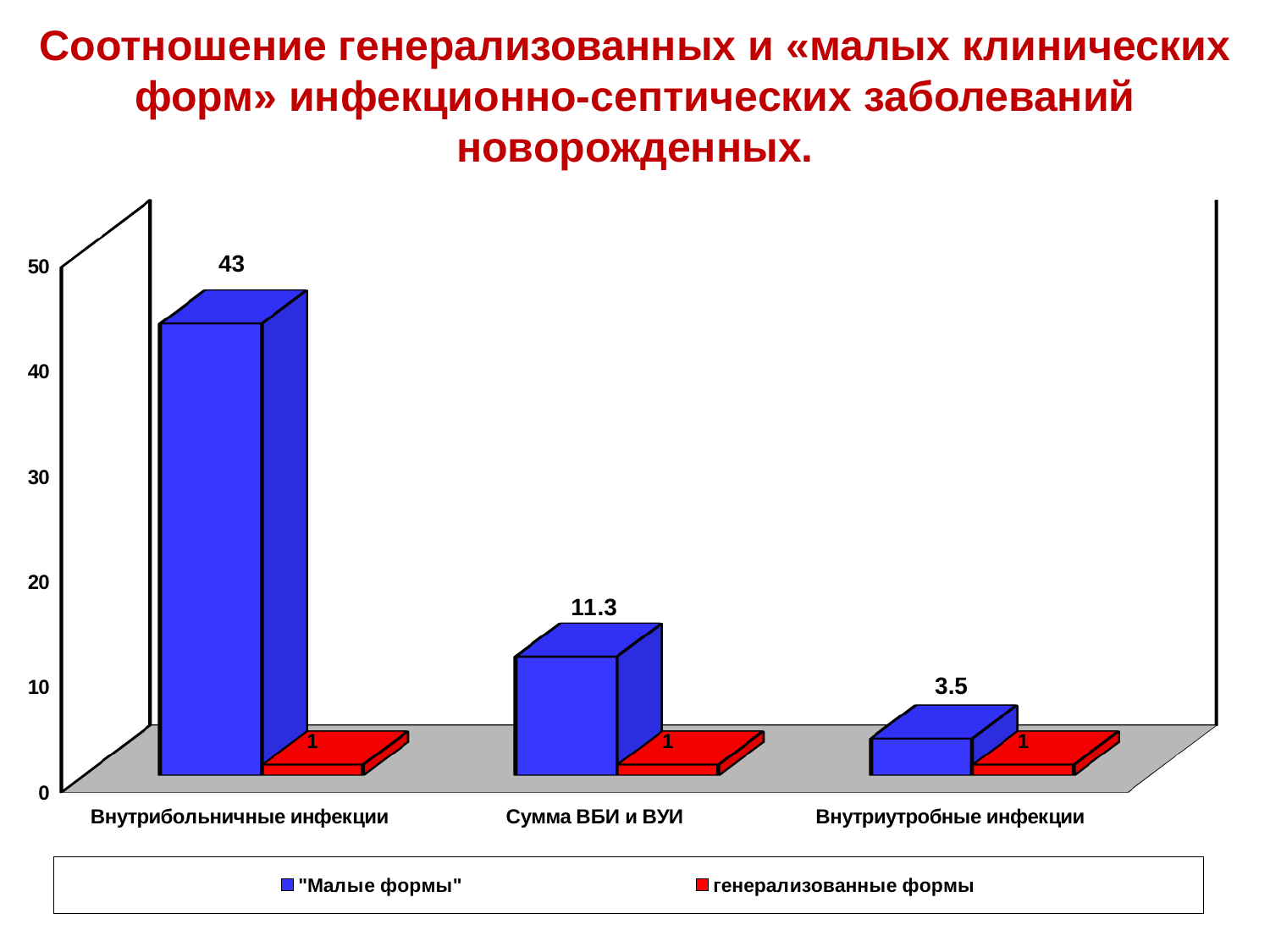
What is the value of генерализованные формы for Внутриутробные инфекции? 1 Which is larger: "Малые формы" for Сумма ВБИ и ВУИ or "Малые формы" for Внутриутробные инфекции? Сумма ВБИ и ВУИ What is the difference between the "Малые формы" values for Внутрибольничные инфекции and Сумма ВБИ и ВУИ? 31.7 Which colour represents генерализованные формы in the chart? Red Which category has the highest value for "Малые формы"? Внутрибольничные инфекции How many categories are shown on the x axis? 3 How many series does the legend list? 2 What kind of chart is shown on the slide? Bar chart What is the value of "Малые формы" for Внутрибольничные инфекции? 43 What is the value of "Малые формы" for Сумма ВБИ и ВУИ? 11.3 What is the value of "Малые формы" for Внутриутробные инфекции? 3.5 Which category has the lowest value for "Малые формы"? Внутриутробные инфекции